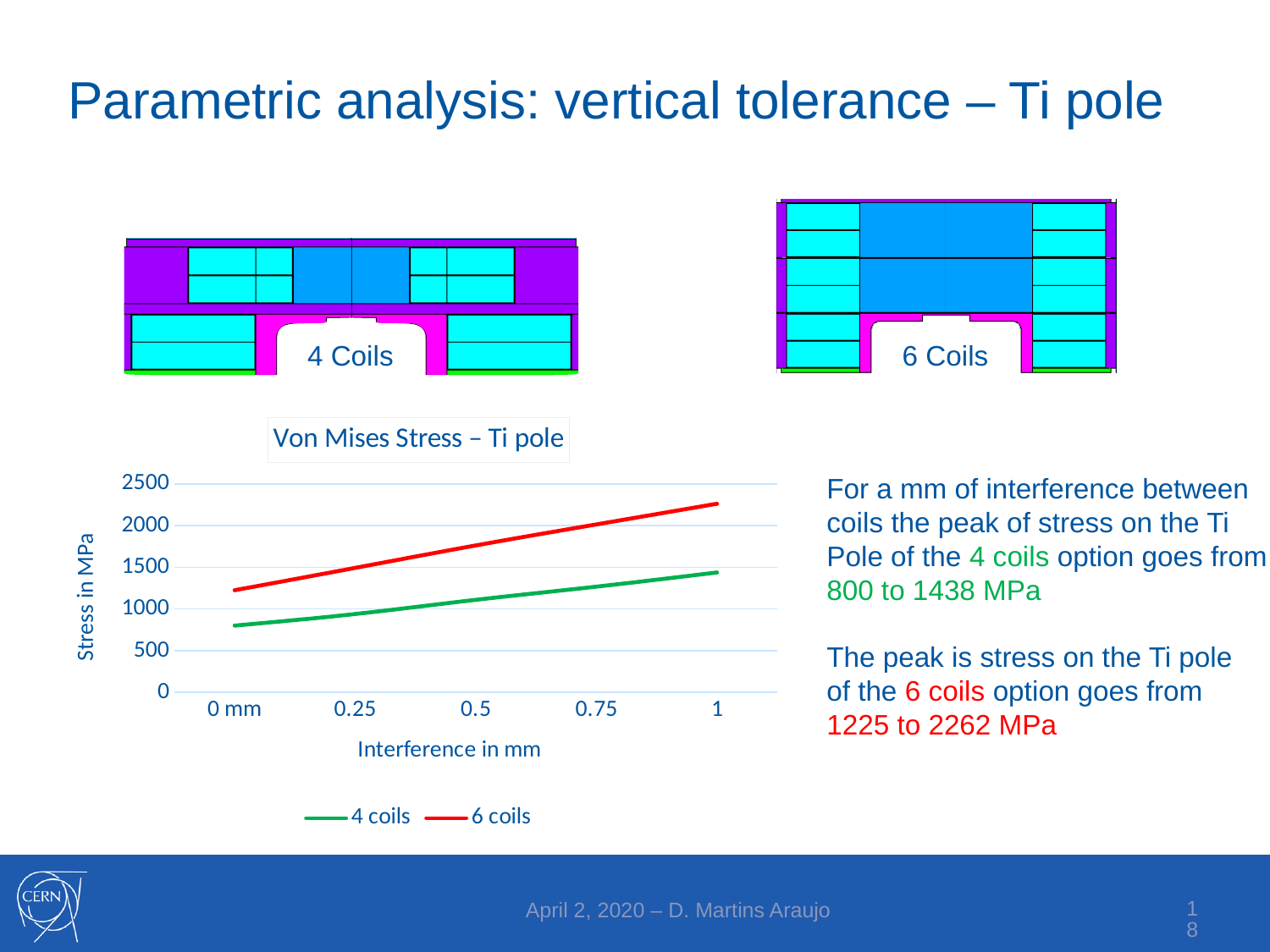
According to the slide, what is the peak stress on the Ti pole for the 4 coils option at 1 mm of interference? 1438 MPa How many interference values are marked along the x axis of the chart? 5 How many series does the legend of the Von Mises Stress chart list? 2 According to the slide, what is the peak stress on the Ti pole for the 6 coils option at 0 mm of interference? 1225 MPa What kind of chart is shown on the slide? line chart At 0.5 mm of interference, is the stress for 4 coils or 6 coils larger? 6 coils Is the stress for 6 coils at 0 mm interference greater or less than 1000 MPa? greater Is the stress for 4 coils at 0 mm interference greater or less than 1000 MPa? less Which series has the higher stress at 1 mm of interference? 6 coils What is the title of the chart? Von Mises Stress – Ti pole Is the stress for 6 coils at 1 mm interference greater or less than 2000 MPa? greater Do the stress values for the 6 coils series rise or fall as interference increases from 0 mm to 1 mm? rise